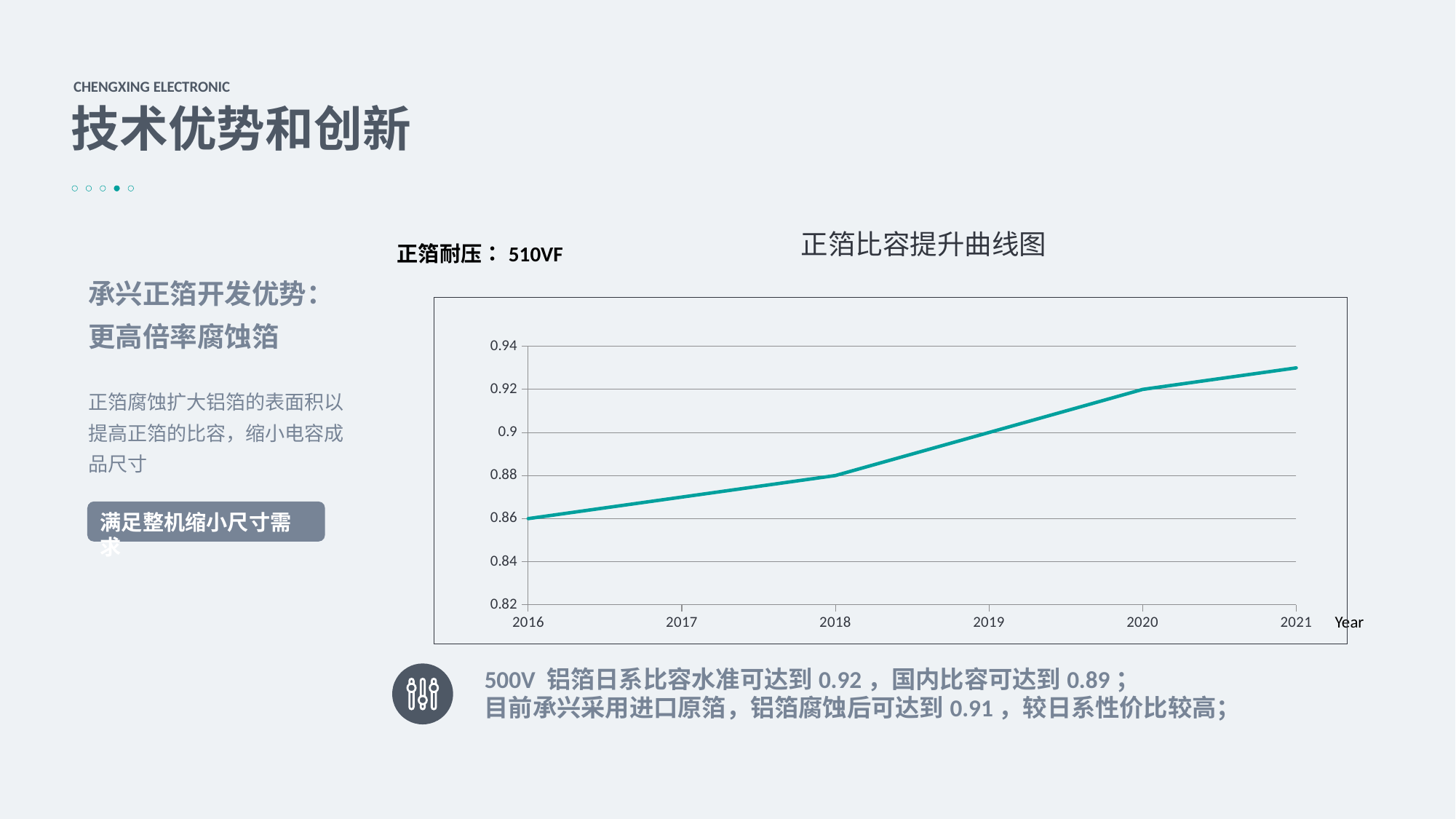
What is the value plotted for 2018? 0.88 What is the value plotted for 2020? 0.92 Is the value for 2017 greater or less than 0.88? less Do the values rise or fall from 2016 to 2021? rise What kind of chart is shown on the slide? line chart What is the title of the chart? 正箔比容提升曲线图 What is the value plotted for 2019? 0.9 How many years are plotted along the x axis of the chart? 6 Which year has the highest value on the chart? 2021 What is the difference between the values for 2020 and 2016? 0.06 What is the value plotted for 2016? 0.86 Which year has the lowest value on the chart? 2016